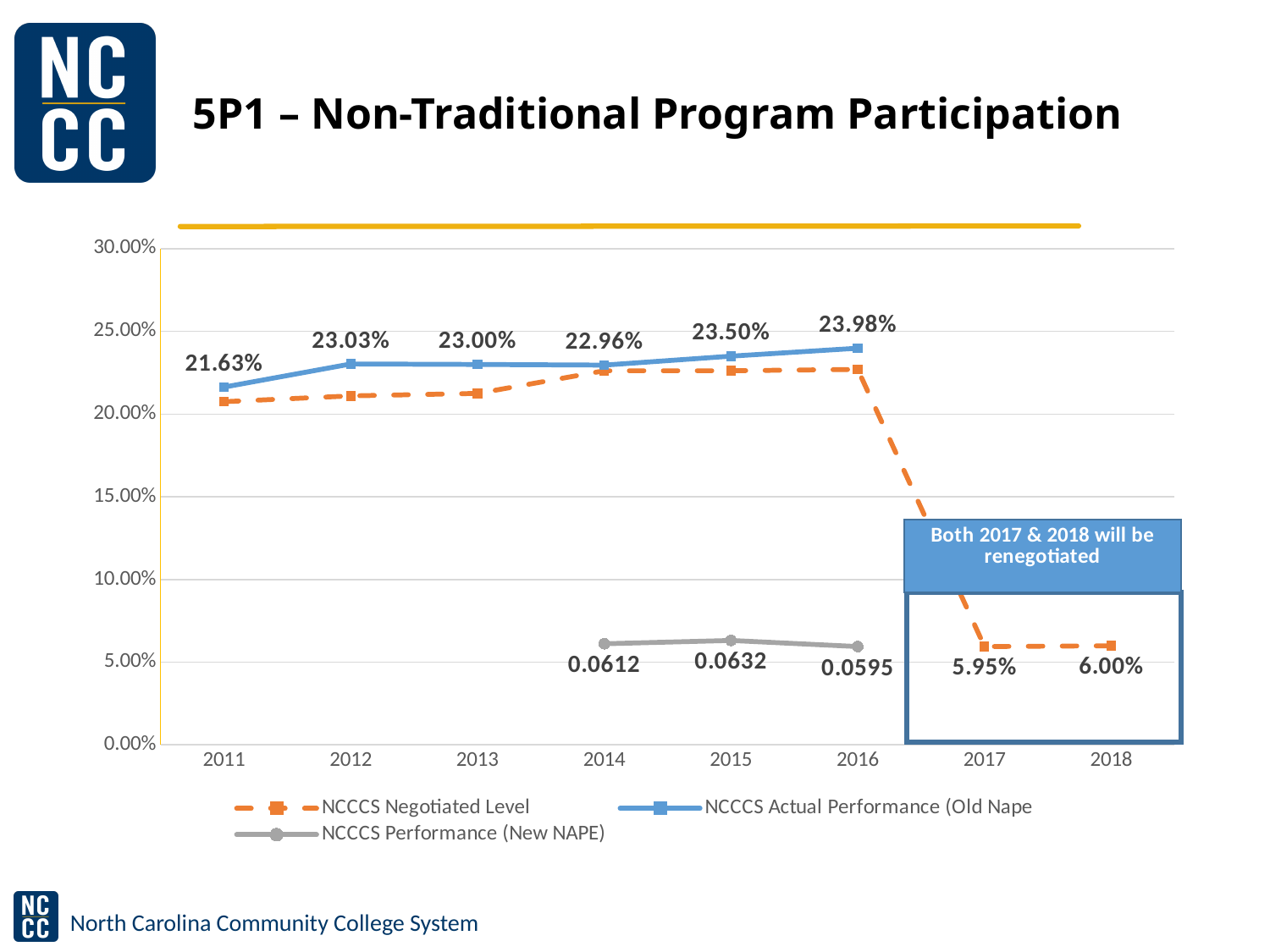
In which year was the NCCCS Actual Performance (Old Nape) highest? 2016 How many series does the legend list? 3 How many years are shown on the x axis? 8 What is the difference between the NCCCS Actual Performance (Old Nape) in 2016 and in 2011? 2.35% What is the NCCCS Performance (New NAPE) value for 2015? 0.0632 What was the NCCCS Actual Performance (Old Nape) value in 2016? 23.98% What was the NCCCS Actual Performance (Old Nape) value in 2011? 21.63% In which year was the NCCCS Actual Performance (Old Nape) lowest? 2011 What is the NCCCS Negotiated Level for 2018? 6.00% Which is larger, the NCCCS Performance (New NAPE) value in 2014 or in 2016? 2014 Is the NCCCS Negotiated Level for 2011 greater or less than 25.00%? less What kind of chart is shown on the slide? line chart